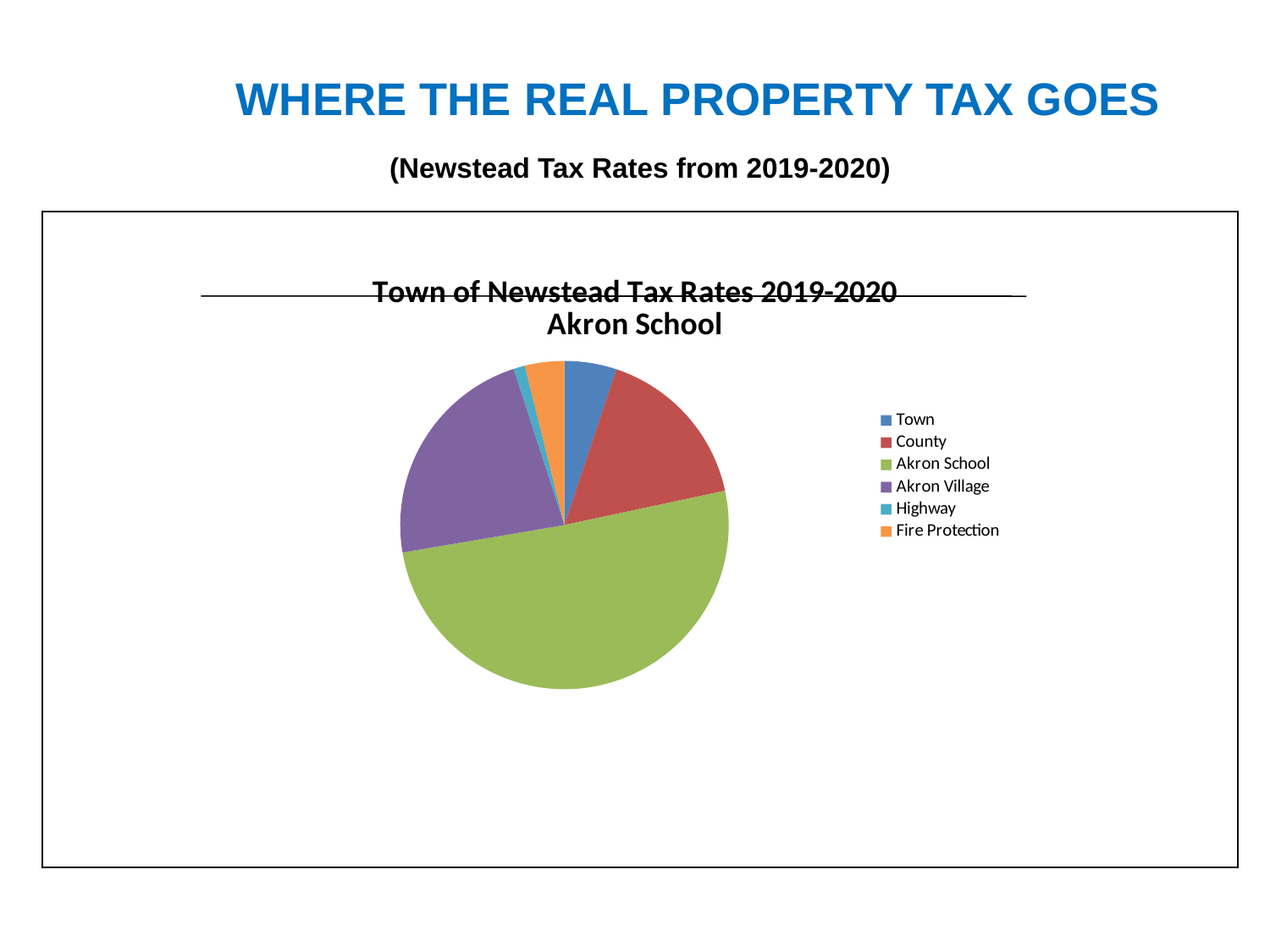
What kind of chart is shown on the slide? pie chart Which category has the largest slice of the pie? Akron School Which slice is larger, County or Town? County How many categories are shown in the pie chart? 6 Which category has the smallest slice of the pie? Highway What colour is the Akron School slice in the pie chart? green Which slice is larger, Akron Village or Fire Protection? Akron Village What is the title of the pie chart? Town of Newstead Tax Rates 2019-2020 Akron School Which slice is larger, Fire Protection or Highway? Fire Protection